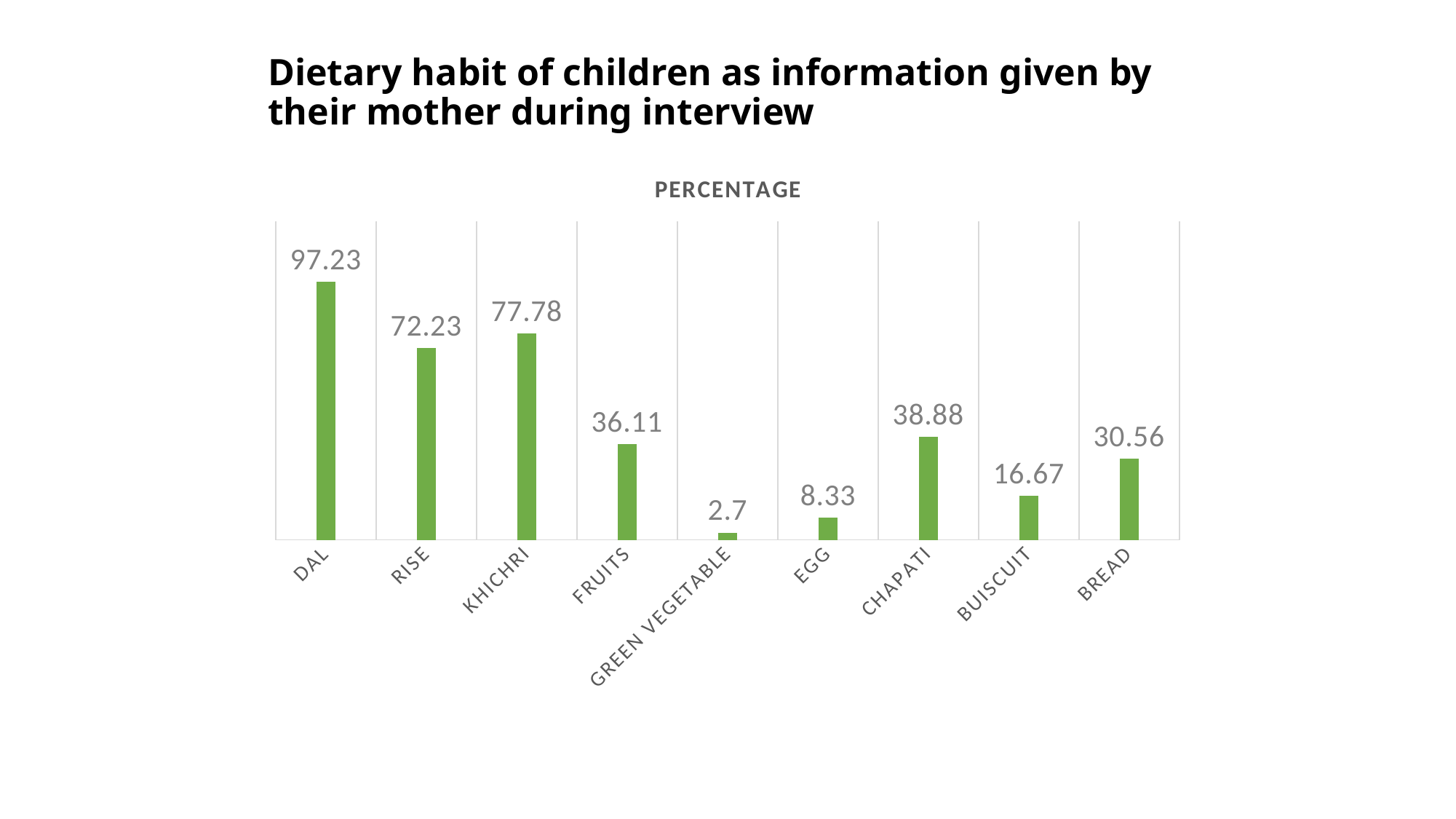
Which is larger, the value for FRUITS or the value for BREAD? FRUITS What is the value for GREEN VEGETABLE? 2.7 How many categories are shown on the x axis? 9 What kind of chart is shown on the slide? Bar chart What is the value for DAL? 97.23 What is the difference between the values for KHICHRI and RISE? 5.55 What is the difference between the values for EGG and GREEN VEGETABLE? 5.63 What is the value for CHAPATI? 38.88 What is the value for BUISCUIT? 16.67 What is the chart's title shown above the plot area? PERCENTAGE Which category has the lowest value? GREEN VEGETABLE Which category has the highest value? DAL